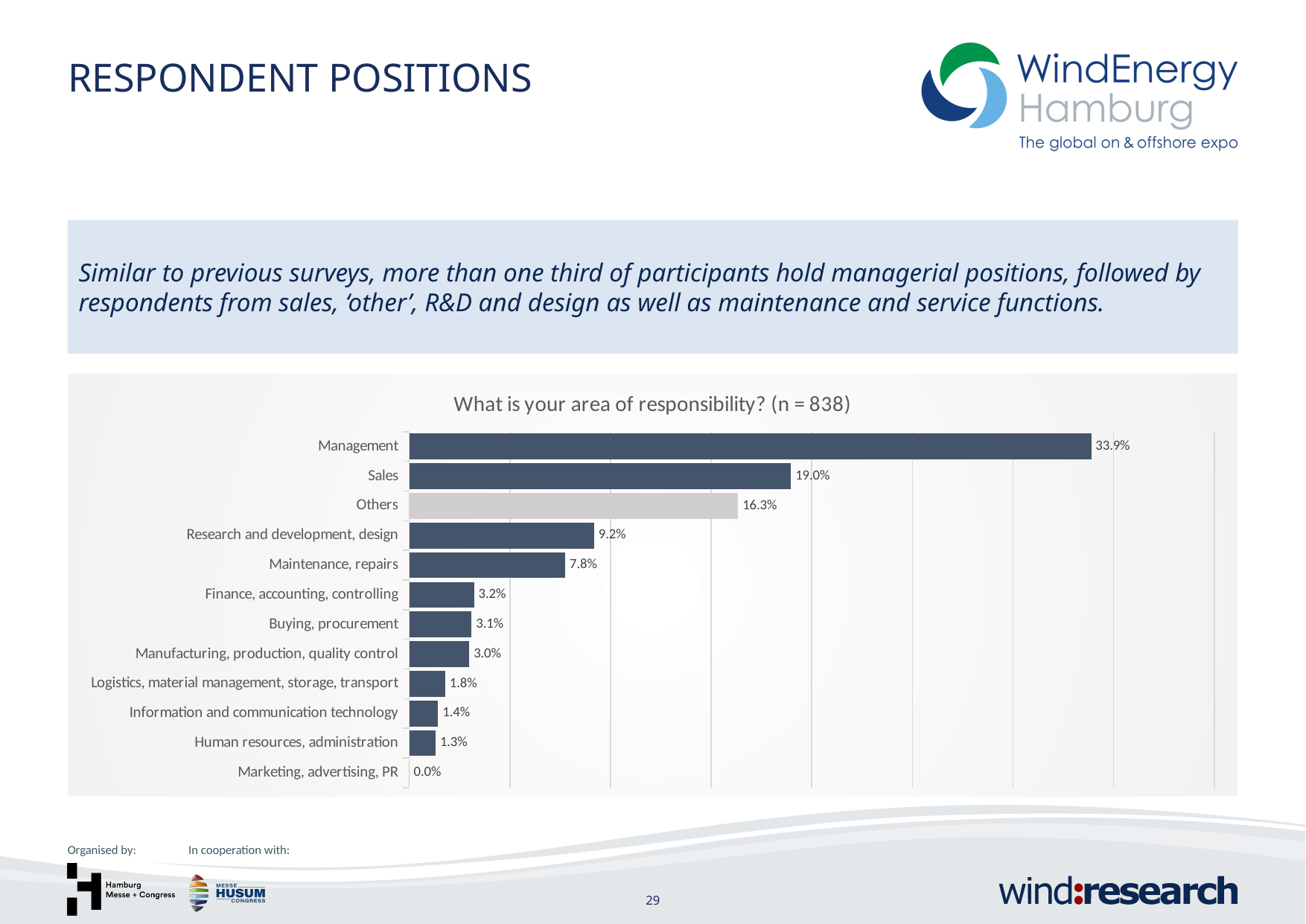
Which is larger, the value for Others or the value for Research and development, design? Others What is the value for Sales? 19.0% What is the value for Maintenance, repairs? 7.8% How many areas of responsibility are listed in the chart? 12 Which area of responsibility has the highest share of respondents? Management Which bar is shown in a different (light grey) colour from the others? Others What is the title of the chart? What is your area of responsibility? (n = 838) What type of chart is shown on the slide? Bar chart What percentage of respondents hold a Management position? 33.9% What is the value for Research and development, design? 9.2% Which area of responsibility has the lowest share of respondents? Marketing, advertising, PR What is the difference between the values for Management and Sales? 14.9%